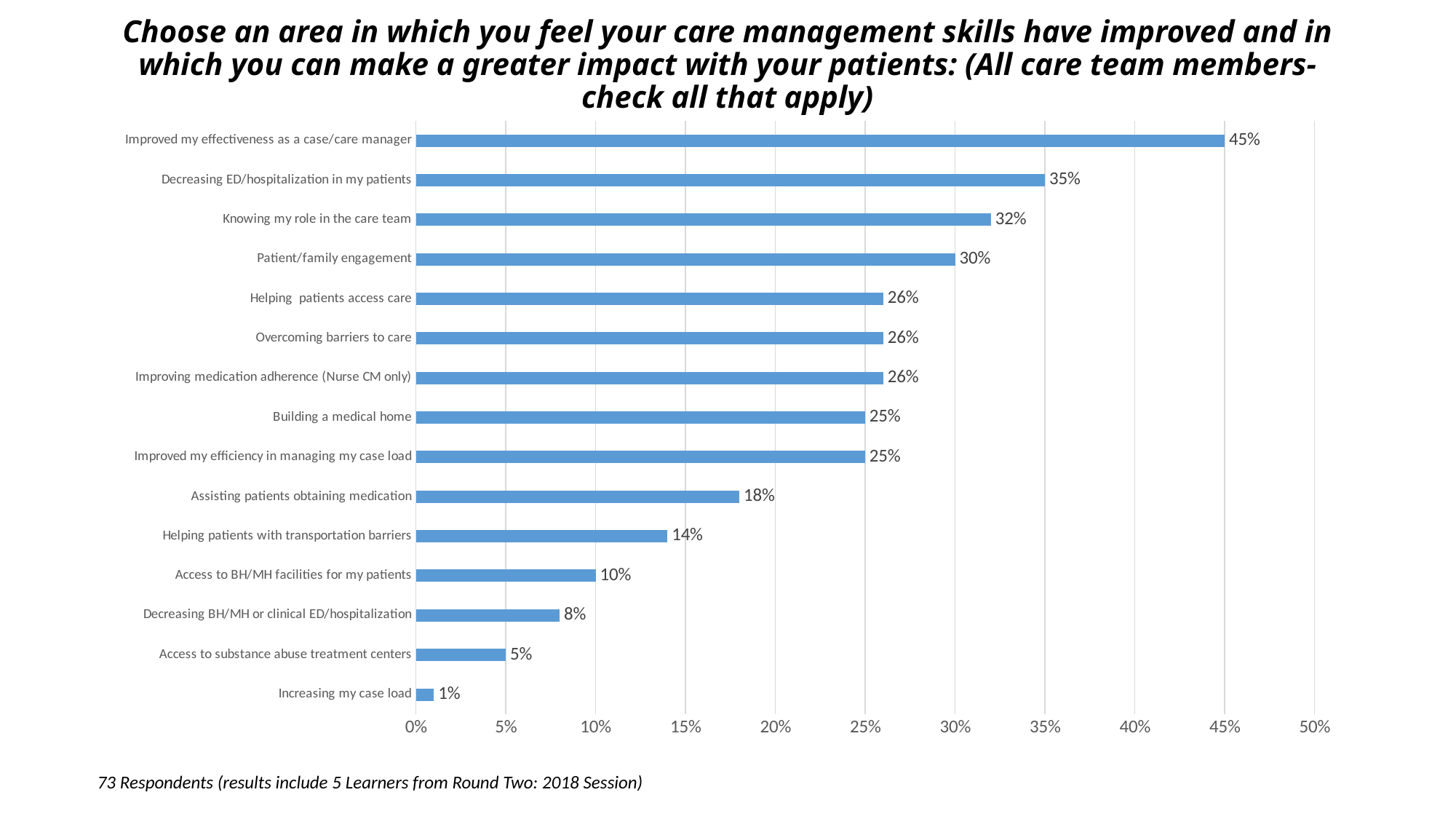
What kind of chart is shown on the slide? Bar chart What is the value for "Knowing my role in the care team"? 32% Which category has the highest value? Improved my effectiveness as a case/care manager How many respondents does the note below the chart say took part? 73 Respondents Is the value for "Decreasing BH/MH or clinical ED/hospitalization" greater or less than 10%? less Which is larger: "Assisting patients obtaining medication" or "Access to BH/MH facilities for my patients"? Assisting patients obtaining medication What is the difference between "Improved my effectiveness as a case/care manager" and "Increasing my case load"? 44% What is the difference between "Decreasing ED/hospitalization in my patients" and "Patient/family engagement"? 5% What percentage of respondents chose "Improved my effectiveness as a case/care manager"? 45% Which category has the lowest value? Increasing my case load How many categories are shown in the chart? 15 What percentage is shown for "Helping patients with transportation barriers"? 14%